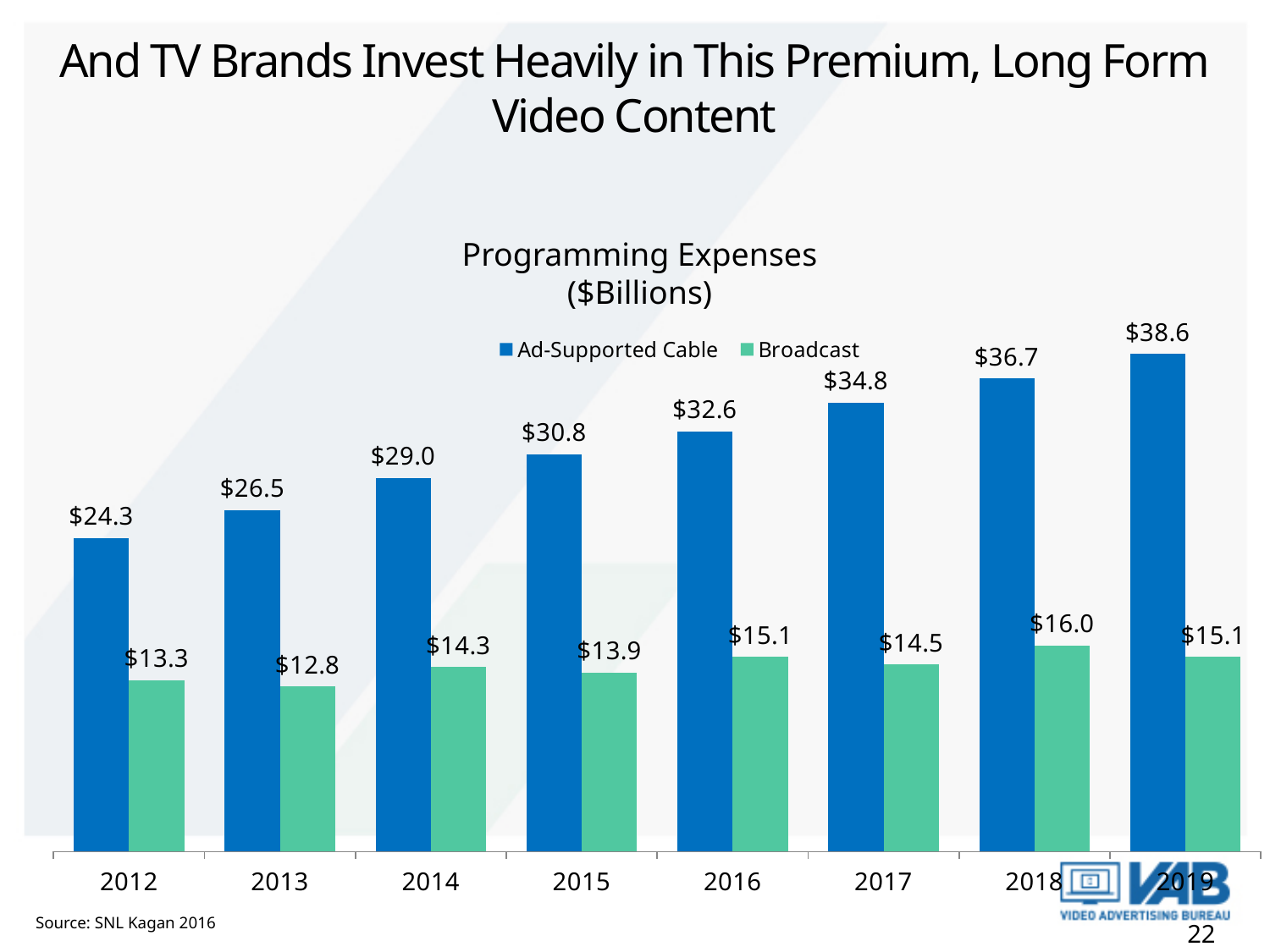
Which year has the highest Ad-Supported Cable programming expense? 2019 How many years are shown on the x axis? 8 Do the Ad-Supported Cable values rise or fall from 2012 to 2019? Rise Which year has the lowest Broadcast programming expense? 2013 What is the Broadcast programming expense for 2018? $16.0 Which is larger, the Broadcast expense in 2016 or in 2017? 2016 What is the title of the chart? Programming Expenses ($Billions) How many series does the legend list? 2 What is the Ad-Supported Cable programming expense for 2015? $30.8 What is the difference between the Ad-Supported Cable and Broadcast programming expenses in 2019? $23.5 By how much did the Ad-Supported Cable programming expense grow from 2012 to 2019? $14.3 What kind of chart is shown on the slide? Bar chart